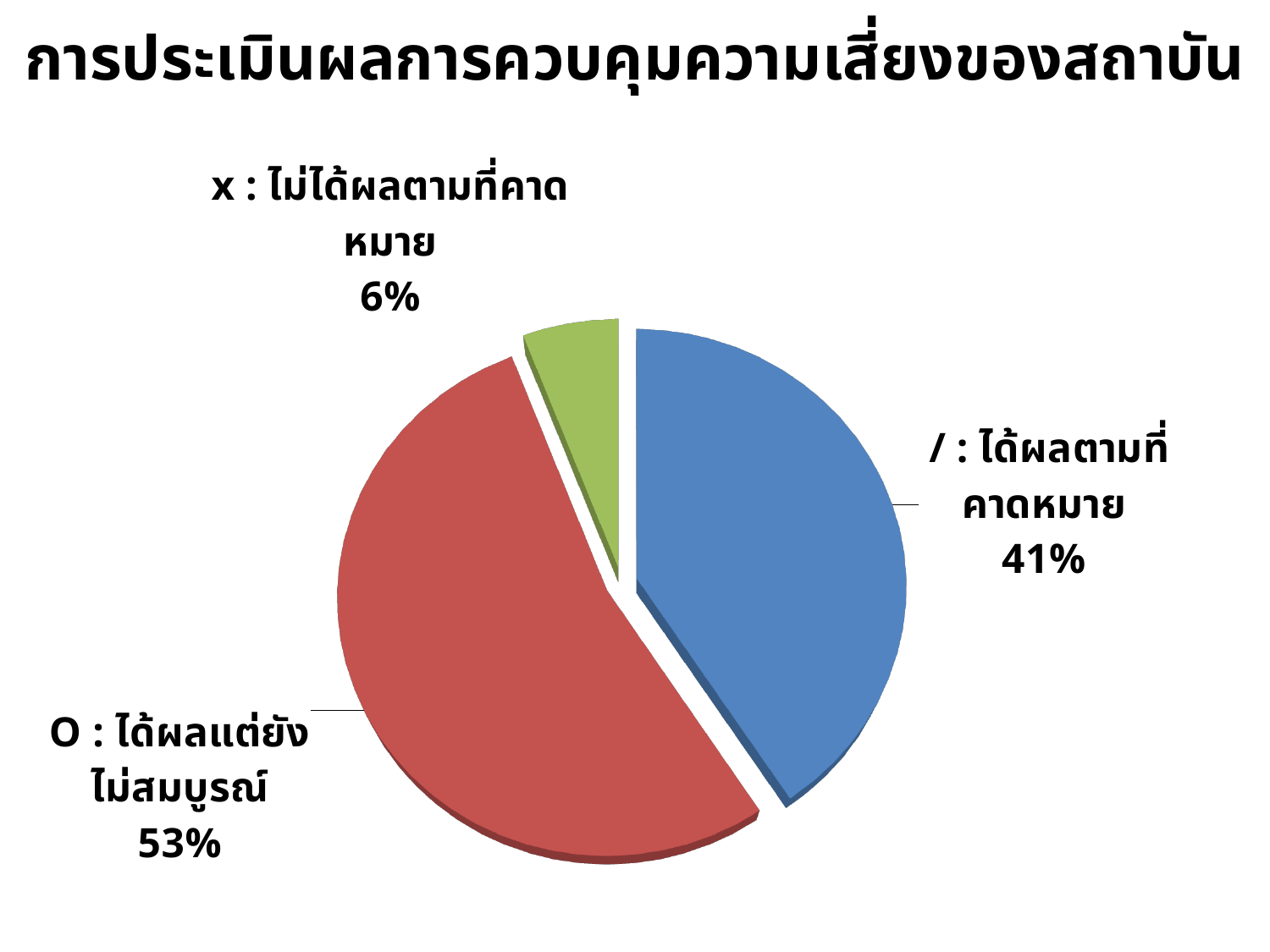
Which slice of the pie is the smallest? x : ไม่ได้ผลตามที่คาดหมาย What kind of chart is shown on the slide? pie chart What share of the pie does the slice "x : ไม่ได้ผลตามที่คาดหมาย" represent? 6% Which is larger, the "/ : ได้ผลตามที่คาดหมาย" slice or the "x : ไม่ได้ผลตามที่คาดหมาย" slice? / : ได้ผลตามที่คาดหมาย What colour is the slice labelled "O : ได้ผลแต่ยังไม่สมบูรณ์"? red What share of the pie does the slice "O : ได้ผลแต่ยังไม่สมบูรณ์" represent? 53% What is the difference in percentage points between the "O : ได้ผลแต่ยังไม่สมบูรณ์" slice and the "/ : ได้ผลตามที่คาดหมาย" slice? 12% What share of the pie does the slice "/ : ได้ผลตามที่คาดหมาย" represent? 41% How many slices does the pie chart have? 3 What is the title of the chart? การประเมินผลการควบคุมความเสี่ยงของสถาบัน Which slice of the pie is the largest? O : ได้ผลแต่ยังไม่สมบูรณ์ What is the combined share of the "/ : ได้ผลตามที่คาดหมาย" and "x : ไม่ได้ผลตามที่คาดหมาย" slices? 47%